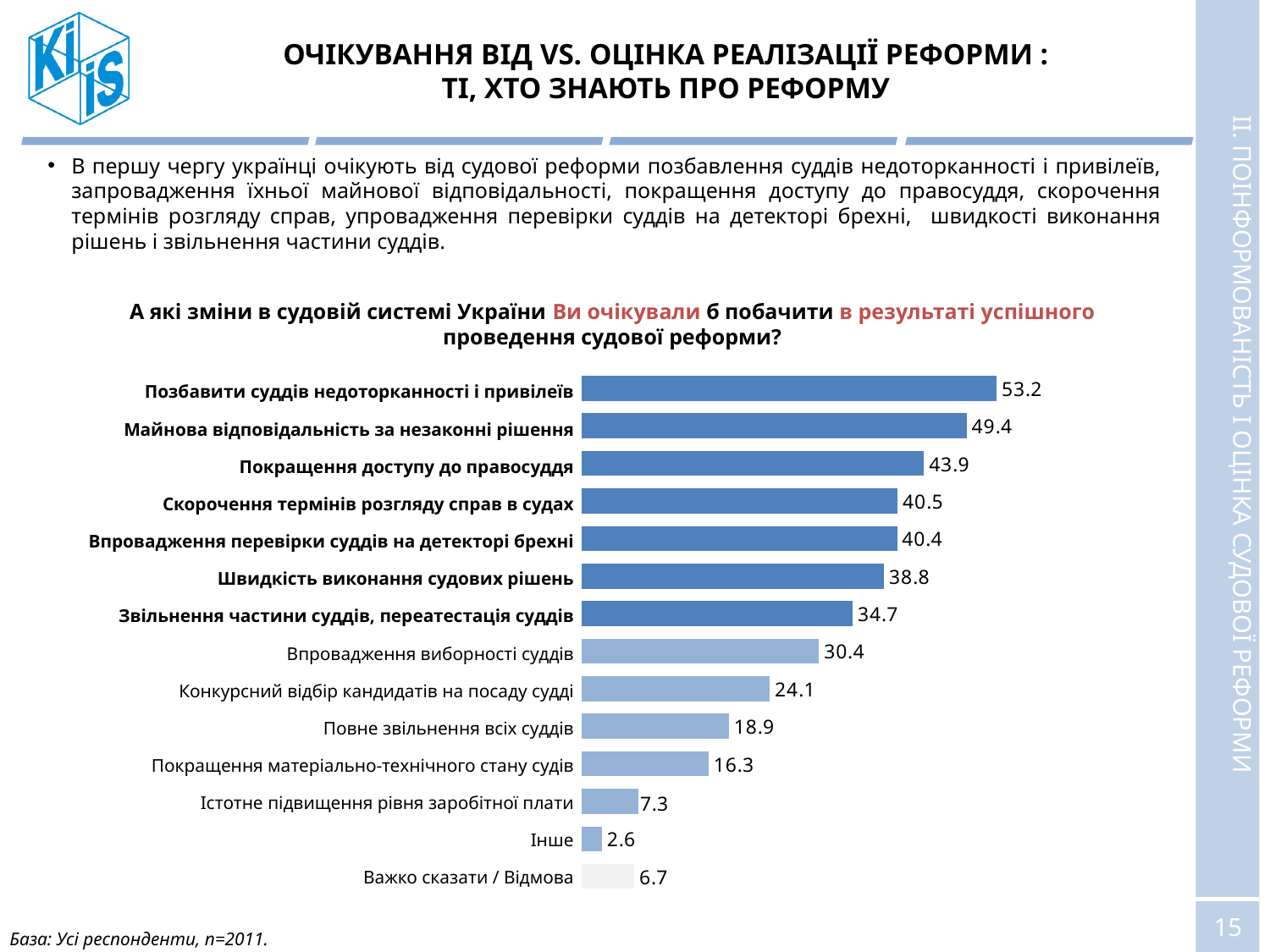
What is the base (sample size) stated at the bottom of the slide? n=2011 What type of chart is shown on the slide? bar chart How many categories are shown in the chart? 14 What is the value for "Важко сказати / Відмова"? 6.7 What is the value for "Конкурсний відбір кандидатів на посаду судді"? 24.1 What is the difference between the values for "Впровадження виборності суддів" and "Істотне підвищення рівня заробітної плати"? 23.1 What is the value for "Позбавити суддів недоторканності і привілеїв"? 53.2 Which category has the highest value? Позбавити суддів недоторканності і привілеїв What is the value for "Покращення доступу до правосуддя"? 43.9 What is the difference between the values for "Майнова відповідальність за незаконні рішення" and "Швидкість виконання судових рішень"? 10.6 Which is larger: the value for "Повне звільнення всіх суддів" or for "Покращення матеріально-технічного стану судів"? Повне звільнення всіх суддів Which category has the lowest value? Інше